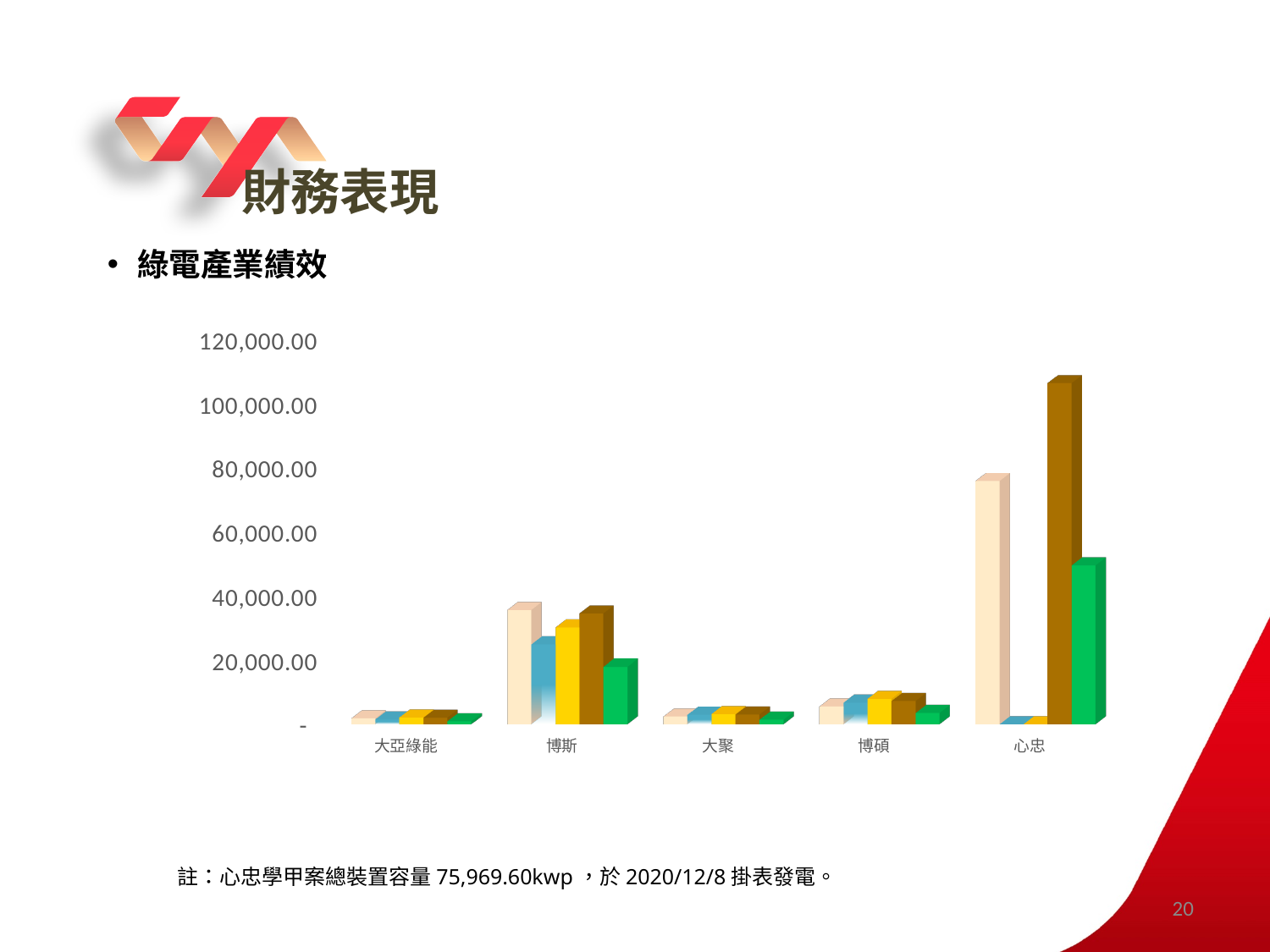
Which company has the tallest bar in the chart? 心忠 How many companies (categories) are shown on the x axis of the chart? 5 Is the green bar for 心忠 greater or less than 40,000.00? greater Which company has the taller bars overall, 博斯 or 大聚? 博斯 What is the highest value shown on the y axis of the chart? 120,000.00 Which company has the taller tallest bar, 心忠 or 博斯? 心忠 Is the tallest bar for 心忠 greater or less than 100,000.00? greater What kind of chart is shown on the slide? bar chart Is the first (beige) bar for 心忠 greater or less than 80,000.00? less How many bars are plotted for each company in the chart? 5